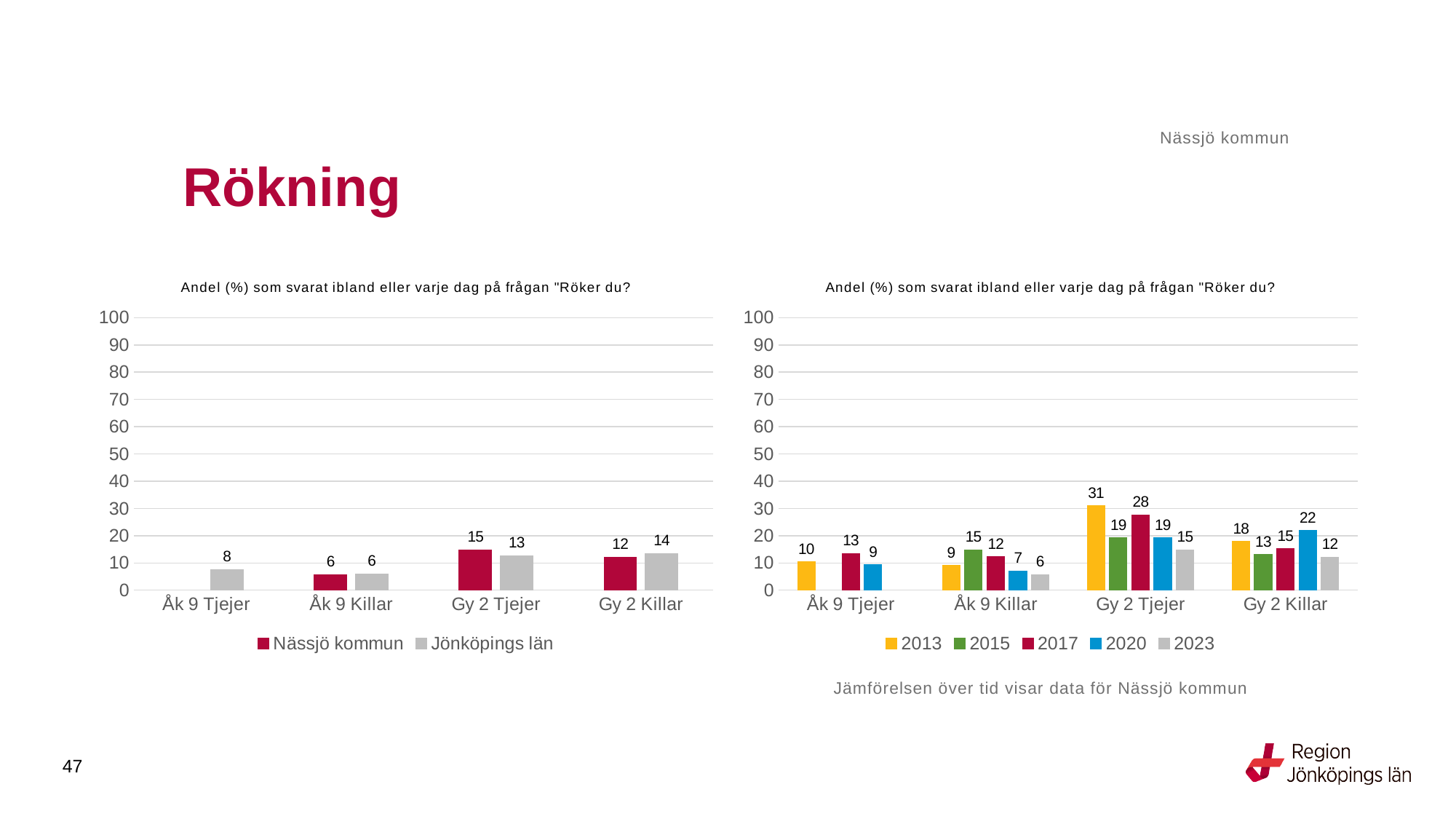
In the left chart, what is the value for Nässjö kommun for Gy 2 Killar? 12 In the right chart, which year has the lowest value for Åk 9 Killar? 2023 What kind of chart is the right chart? Bar chart In the right chart, is the value for 2017 for Gy 2 Tjejer greater or less than 20? greater In the left chart, what is the difference between Jönköpings län and Nässjö kommun for Gy 2 Killar? 2 In the left chart, which category has the highest value for Nässjö kommun? Gy 2 Tjejer In the right chart, what is the value for 2020 for Gy 2 Killar? 22 In the left chart, how many series does the legend list? 2 In the right chart, what is the difference between the 2013 and 2023 values for Gy 2 Tjejer? 16 In the right chart, how many series does the legend list? 5 In the right chart, what is the value for 2013 for Gy 2 Tjejer? 31 In the left chart, what is the value for Jönköpings län for Gy 2 Tjejer? 13